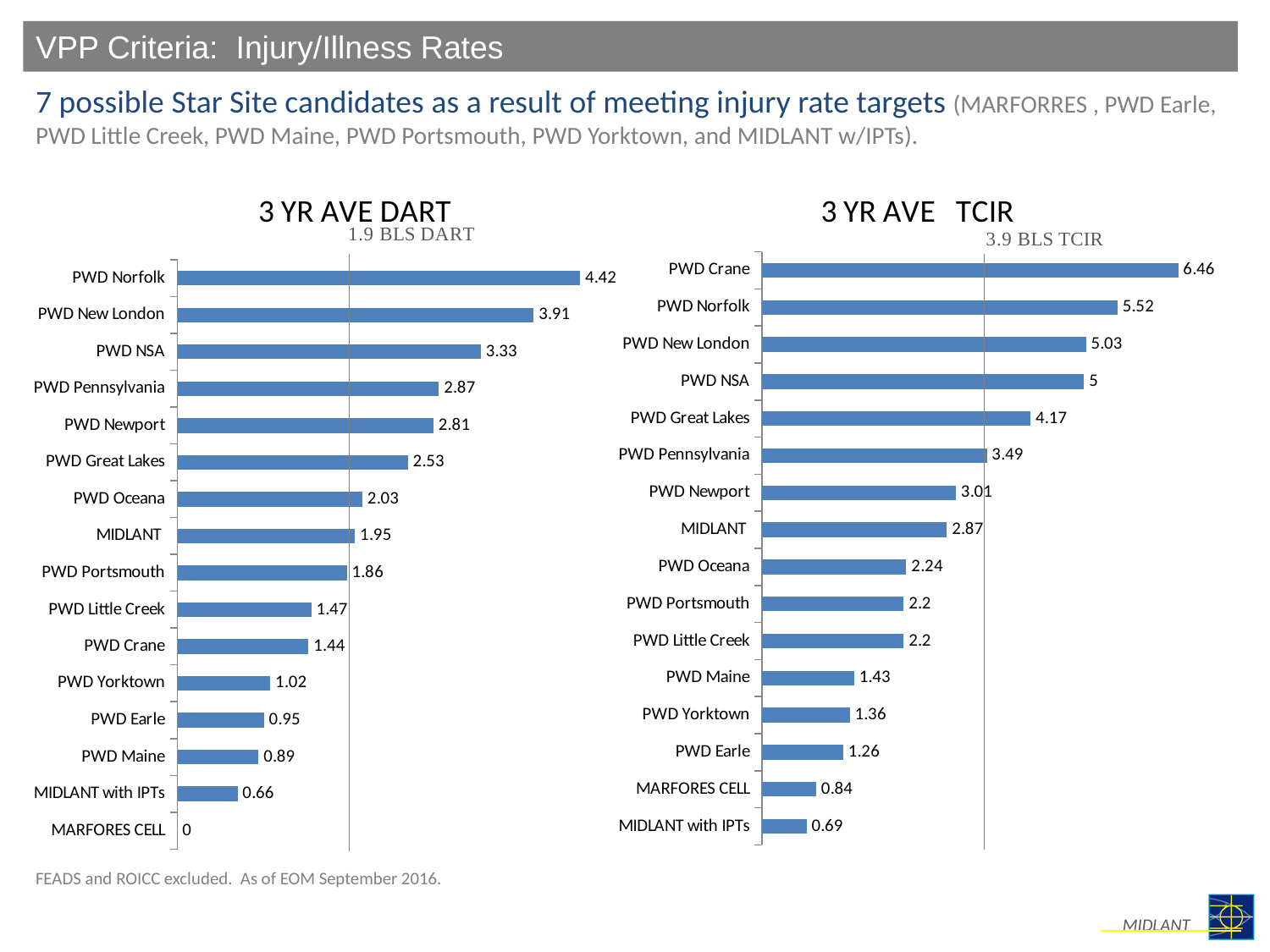
In the 3 YR AVE DART chart, what is the difference between PWD Norfolk and PWD New London? 0.51 In the 3 YR AVE TCIR chart, which site has the lowest value? MIDLANT with IPTs In the 3 YR AVE DART chart, which site has the lowest value? MARFORES CELL In the 3 YR AVE DART chart, which is larger, the value for PWD Crane or the value for PWD Yorktown? PWD Crane In the 3 YR AVE DART chart, what is the value for MIDLANT with IPTs? 0.66 In the 3 YR AVE TCIR chart, which site has the highest value? PWD Crane How many sites are shown in the 3 YR AVE DART chart? 16 What BLS benchmark value is marked on the 3 YR AVE TCIR chart? 3.9 BLS TCIR In the 3 YR AVE TCIR chart, what is the difference between PWD Crane and PWD Norfolk? 0.94 In the 3 YR AVE DART chart, what is the value for PWD Norfolk? 4.42 What type of chart is the 3 YR AVE TCIR chart? Bar chart In the 3 YR AVE TCIR chart, what is the value for PWD Great Lakes? 4.17